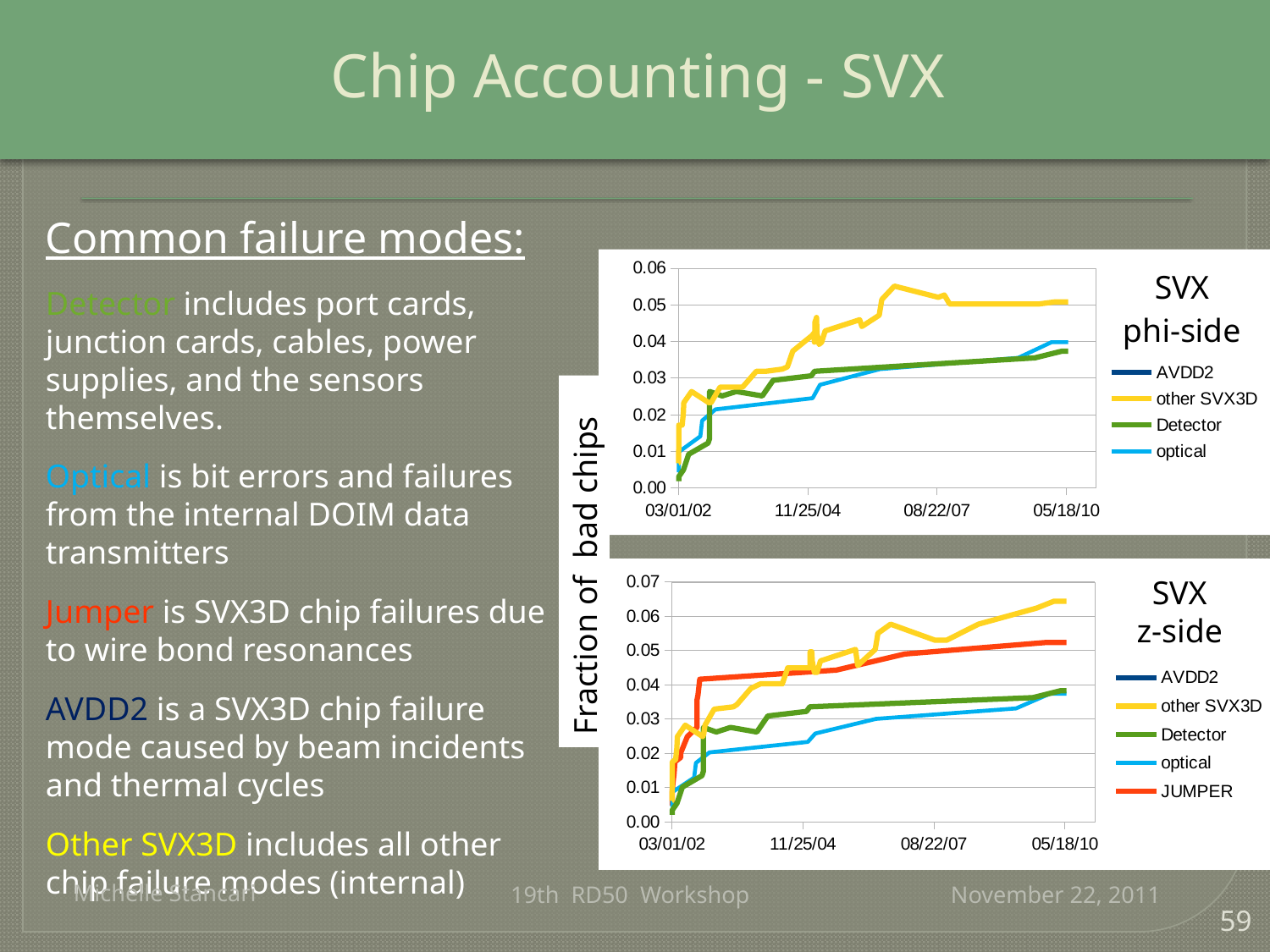
In the SVX z-side chart, which is higher at 05/18/10: JUMPER or optical? JUMPER What kind of chart is the SVX phi-side chart? line chart In the SVX phi-side chart, which series reaches the highest value? other SVX3D How many series does the legend of the SVX phi-side chart list? 4 What is the label on the shared vertical axis of the two charts? Fraction of bad chips In the SVX z-side chart, which series reaches the highest value? other SVX3D In the SVX z-side chart, is the value of optical at 05/18/10 greater or less than 0.05? less How many series does the legend of the SVX z-side chart list? 5 In the SVX phi-side chart, does the Detector series generally rise or fall over time? rise In the SVX phi-side chart, is the value of other SVX3D at 08/22/07 greater or less than 0.04? greater Which series appears in the SVX z-side legend but not in the SVX phi-side legend? JUMPER In the SVX z-side chart, is the value of JUMPER at 05/18/10 greater or less than 0.04? greater